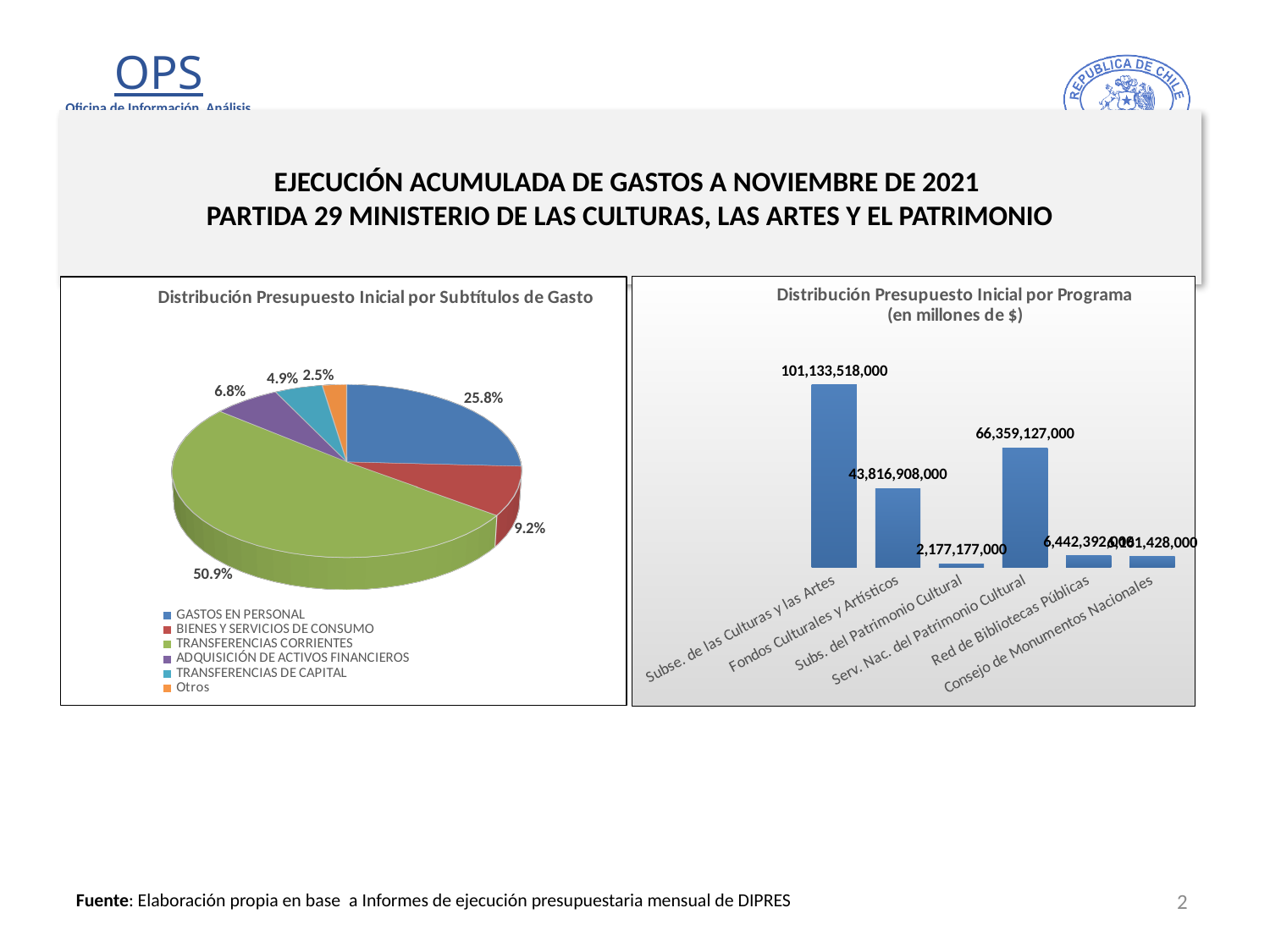
What type of chart is 'Distribución Presupuesto Inicial por Programa'? Bar chart In the pie chart 'Distribución Presupuesto Inicial por Subtítulos de Gasto', what share does BIENES Y SERVICIOS DE CONSUMO have? 9.2% In the bar chart 'Distribución Presupuesto Inicial por Programa', what is the value for Subs. del Patrimonio Cultural? 2,177,177,000 How many categories does the legend of the pie chart 'Distribución Presupuesto Inicial por Subtítulos de Gasto' list? 6 In the bar chart 'Distribución Presupuesto Inicial por Programa', which program has the highest value? Subse. de las Culturas y las Artes In the pie chart 'Distribución Presupuesto Inicial por Subtítulos de Gasto', which category has the largest share? TRANSFERENCIAS CORRIENTES In the pie chart 'Distribución Presupuesto Inicial por Subtítulos de Gasto', what share does GASTOS EN PERSONAL have? 25.8% In the bar chart 'Distribución Presupuesto Inicial por Programa', which is larger: Fondos Culturales y Artísticos or Serv. Nac. del Patrimonio Cultural? Serv. Nac. del Patrimonio Cultural In the pie chart 'Distribución Presupuesto Inicial por Subtítulos de Gasto', what share does TRANSFERENCIAS CORRIENTES have? 50.9% In the bar chart 'Distribución Presupuesto Inicial por Programa', what is the value for Serv. Nac. del Patrimonio Cultural? 66,359,127,000 In the bar chart 'Distribución Presupuesto Inicial por Programa', what is the value for Subse. de las Culturas y las Artes? 101,133,518,000 In the pie chart 'Distribución Presupuesto Inicial por Subtítulos de Gasto', which category has the smallest share? Otros